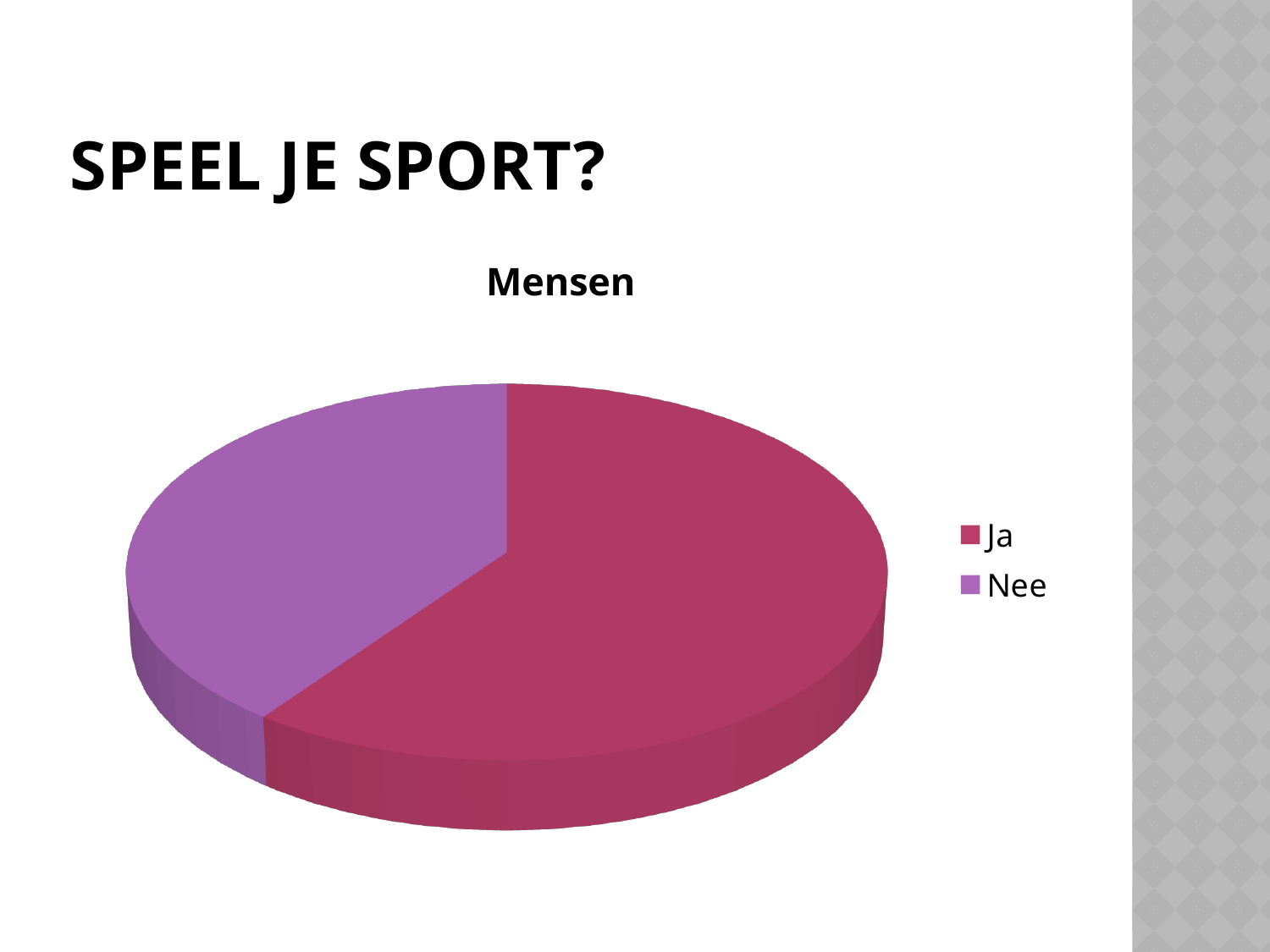
Which category has the smallest slice of the pie? Nee What are the two categories listed in the legend? Ja and Nee Which category has the largest slice of the pie? Ja What colour is the Nee slice in the pie chart? purple How many entries does the legend list? 2 Is the share of the pie for Nee greater or less than half? less What is the title of the chart? Mensen How many slices does the pie chart have? 2 Which slice is larger, Ja or Nee? Ja Is the share of the pie for Ja greater or less than half? greater What kind of chart is shown on the slide? pie chart